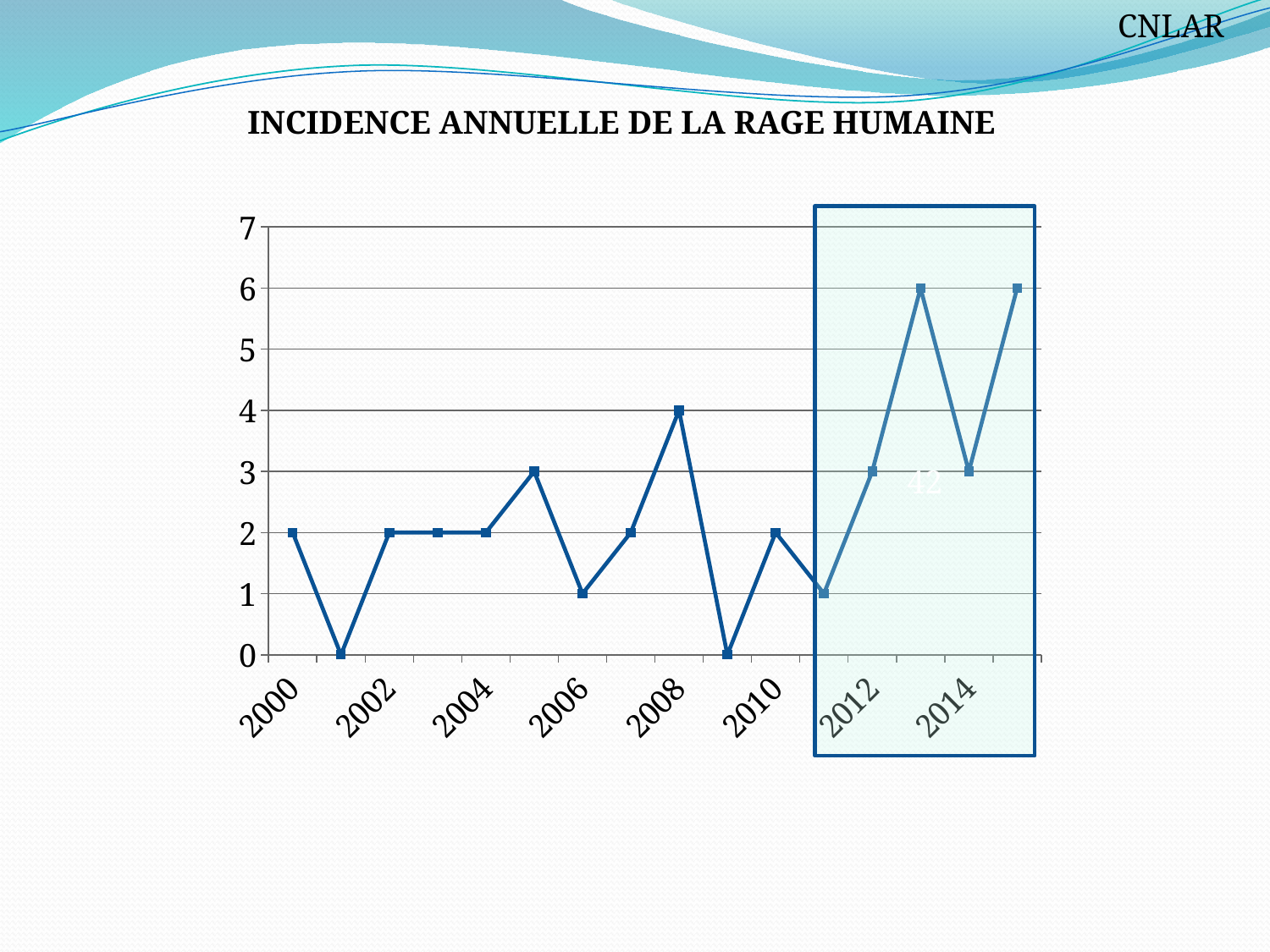
Is the value for 2014 greater or less than 2? greater What is the value for 2008? 4 Which year has the larger value, 2008 or 2010? 2008 What is the value for 2006? 1 What is the difference between the values for 2012 and 2010? 1 What is the value for 2000? 2 What is the value for 2012? 3 What kind of chart is shown on the slide? line chart What is the value for 2014? 3 Do the values rise or fall from 2006 to 2008? rise How many data points are plotted on the line? 16 What is the difference between the values for 2008 and 2006? 3